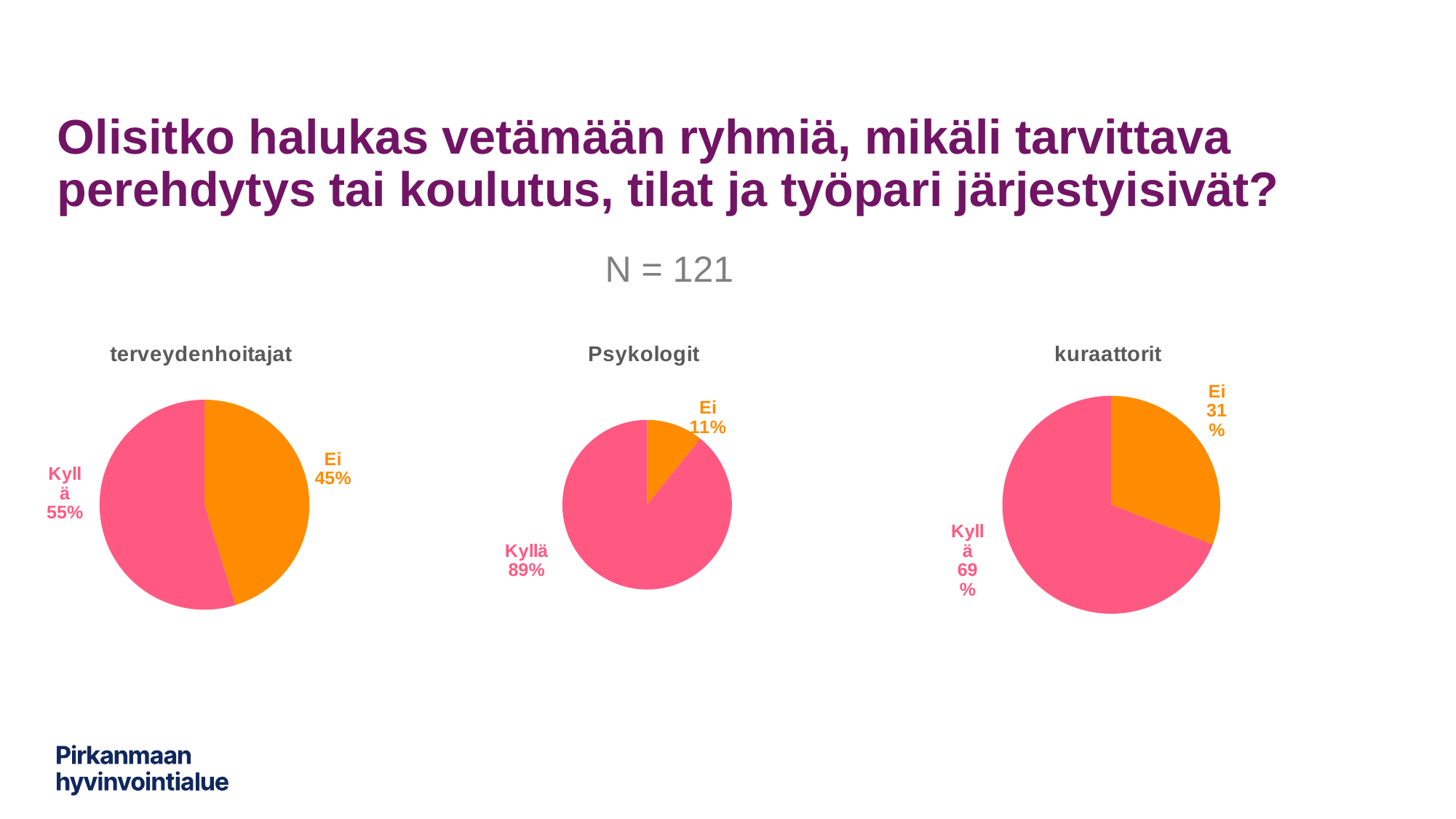
In the 'kuraattorit' pie chart, what share is labelled 'Ei'? 31% In the 'terveydenhoitajat' pie chart, what share is labelled 'Ei'? 45% In the 'Psykologit' pie chart, which slice is the largest? Kyllä In the 'terveydenhoitajat' pie chart, what is the difference between the 'Kyllä' and 'Ei' shares? 10% How many pie charts are shown on the slide? 3 In the 'Psykologit' pie chart, what share is labelled 'Ei'? 11% Which is larger: the 'Ei' share in the 'Psykologit' chart or the 'Ei' share in the 'kuraattorit' chart? kuraattorit In the 'kuraattorit' pie chart, which slice is the smallest? Ei What kind of chart is used for the 'Psykologit' data? Pie chart